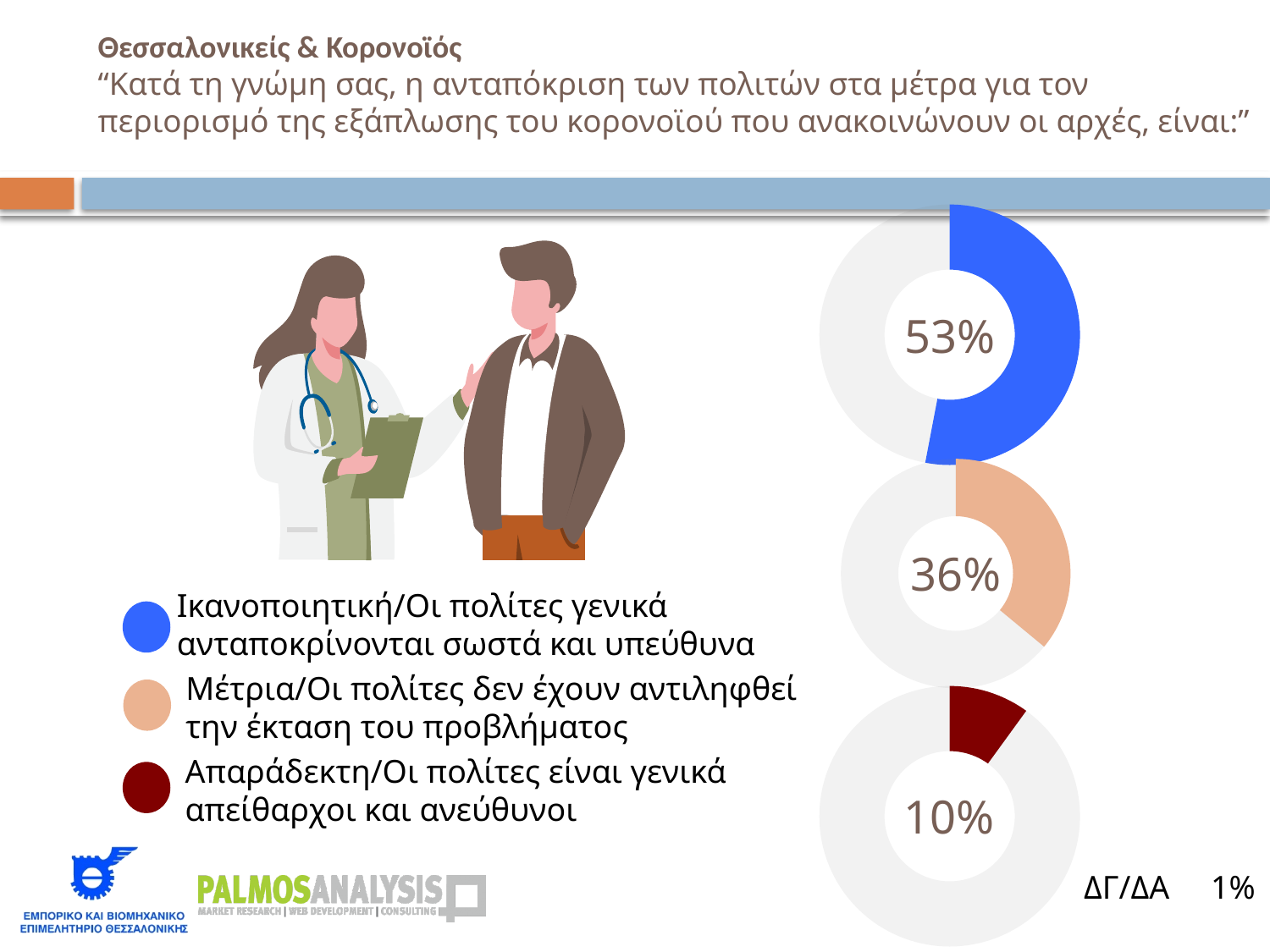
Which is larger, the percentage for "Μέτρια" or for "Απαράδεκτη"? Μέτρια What percentage is shown for ΔΓ/ΔΑ (don't know / no answer)? 1% What percentage of respondents answered "Ικανοποιητική" (citizens generally respond correctly and responsibly)? 53% How many response categories are listed in the legend? 3 What is the difference in percentage points between the "Μέτρια" and "Απαράδεκτη" responses? 26 Which response category has the highest percentage? Ικανοποιητική What type of chart is used to display the percentages on the slide? Donut (pie) chart What percentage of respondents answered "Απαράδεκτη" (citizens are generally undisciplined and irresponsible)? 10% Which of the three legend categories has the lowest percentage? Απαράδεκτη What is the difference in percentage points between the "Ικανοποιητική" and "Μέτρια" responses? 17 What colour represents the "Απαράδεκτη" category? Dark red What percentage of respondents answered "Μέτρια" (citizens have not grasped the extent of the problem)? 36%